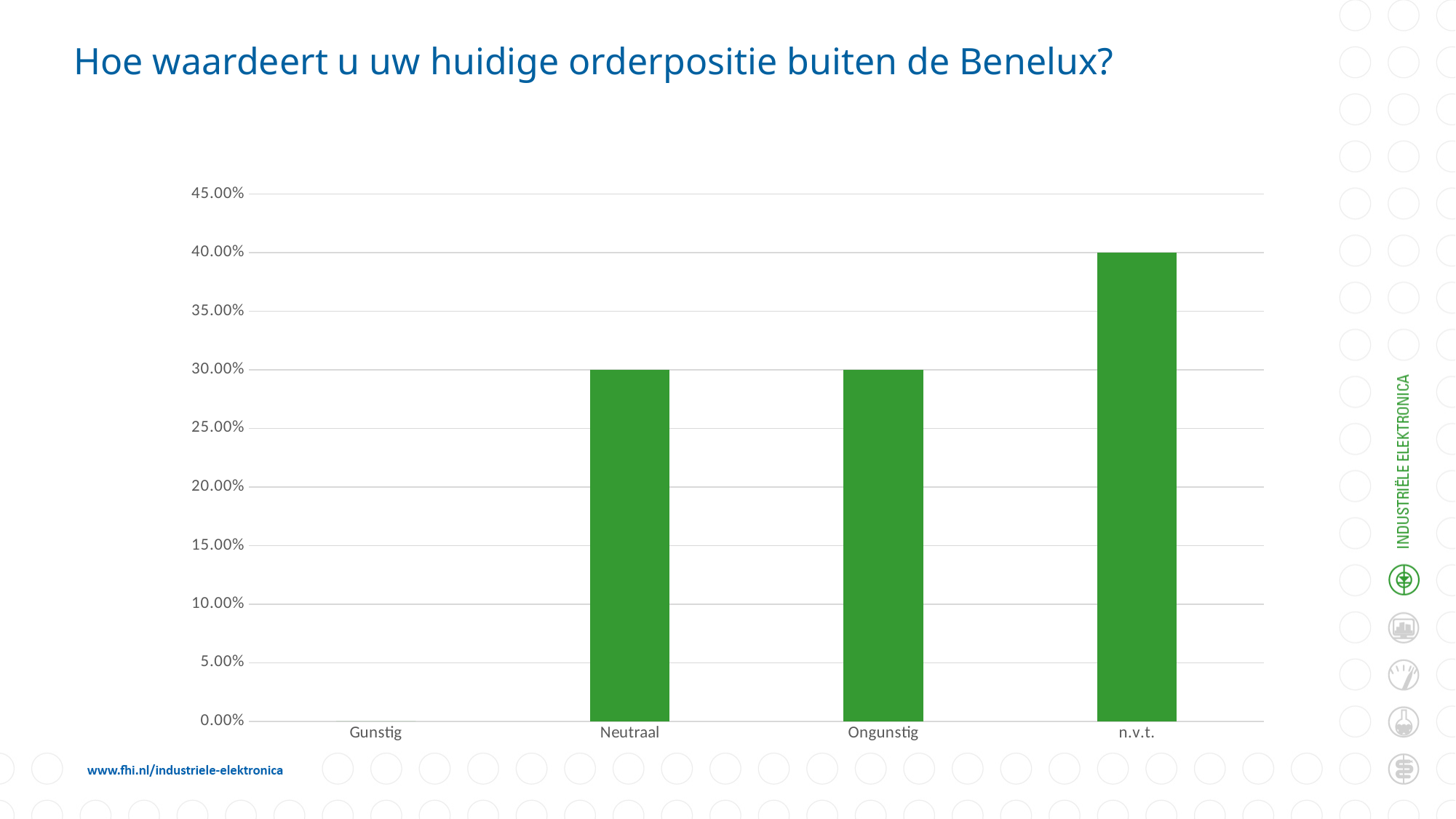
What is the value for Ongunstig? 30.00% What is the value for Neutraal? 30.00% Which category has the lowest value? Gunstig What type of chart is shown on the slide? bar chart What is the value for n.v.t.? 40.00% Is the value for n.v.t. greater or less than 35.00%? greater Which category has the highest value? n.v.t. What colour are the bars in the chart? green How many categories are shown on the x axis? 4 Which is larger, the value for n.v.t. or the value for Ongunstig? n.v.t. What is the difference between the values for n.v.t. and Neutraal? 10.00% What is the title of the slide? Hoe waardeert u uw huidige orderpositie buiten de Benelux?